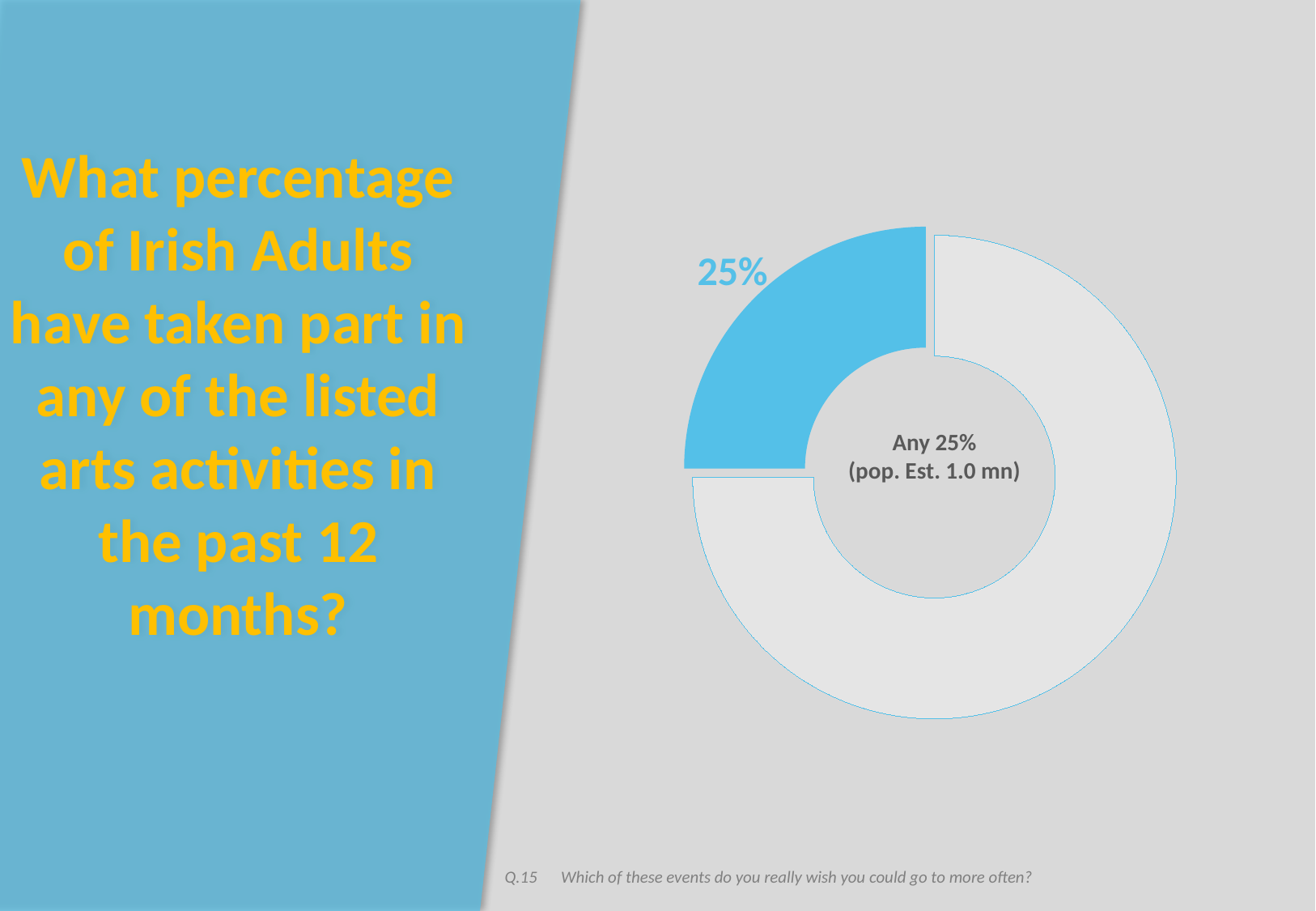
What kind of chart is shown on the slide? doughnut chart What percentage is shown for the blue highlighted segment of the doughnut chart? 25% What text is printed in the centre of the doughnut chart? Any 25% (pop. Est. 1.0 mn) What population estimate is printed in the centre of the doughnut chart? 1.0 mn What colour is the segment labelled 25% in the doughnut chart? blue Which segment of the doughnut chart is the smallest? the blue segment (25%) How many segments does the doughnut chart have? 2 What share of the doughnut chart does the blue segment represent? 25% Which segment of the doughnut chart is larger, the blue segment or the grey segment? the grey segment